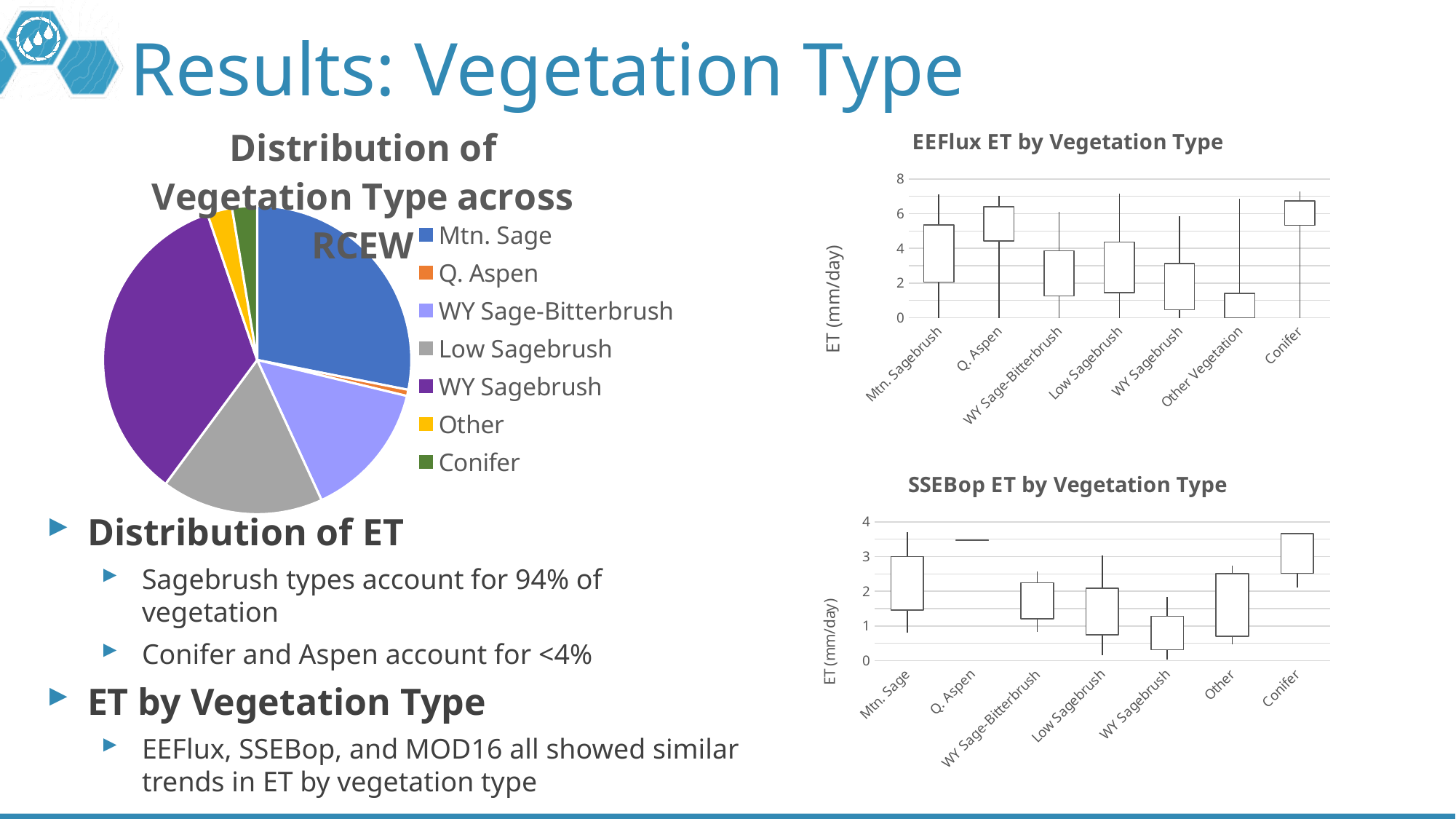
What is the y-axis label of the 'EEFlux ET by Vegetation Type' chart? ET (mm/day) In the 'Distribution of Vegetation Type across RCEW' pie chart, what colour is the WY Sagebrush slice? Purple In the 'Distribution of Vegetation Type across RCEW' pie chart, which vegetation type has the smallest slice? Q. Aspen In the 'Distribution of Vegetation Type across RCEW' pie chart, which vegetation type has the largest slice? WY Sagebrush In the 'EEFlux ET by Vegetation Type' chart, is the top of the box for Other Vegetation greater or less than 2? less What kind of chart is 'EEFlux ET by Vegetation Type'? Box plot How many vegetation types does the legend of the 'Distribution of Vegetation Type across RCEW' pie chart list? 7 What kind of chart is the 'Distribution of Vegetation Type across RCEW' chart? Pie chart How many vegetation types are shown on the x axis of the 'EEFlux ET by Vegetation Type' chart? 7 In the 'EEFlux ET by Vegetation Type' chart, is the top of the box for Conifer greater or less than 4? greater In the 'Distribution of Vegetation Type across RCEW' pie chart, which slice is larger, Mtn. Sage or Low Sagebrush? Mtn. Sage In the 'SSEBop ET by Vegetation Type' chart, is the bottom of the box for Conifer greater or less than 2? greater